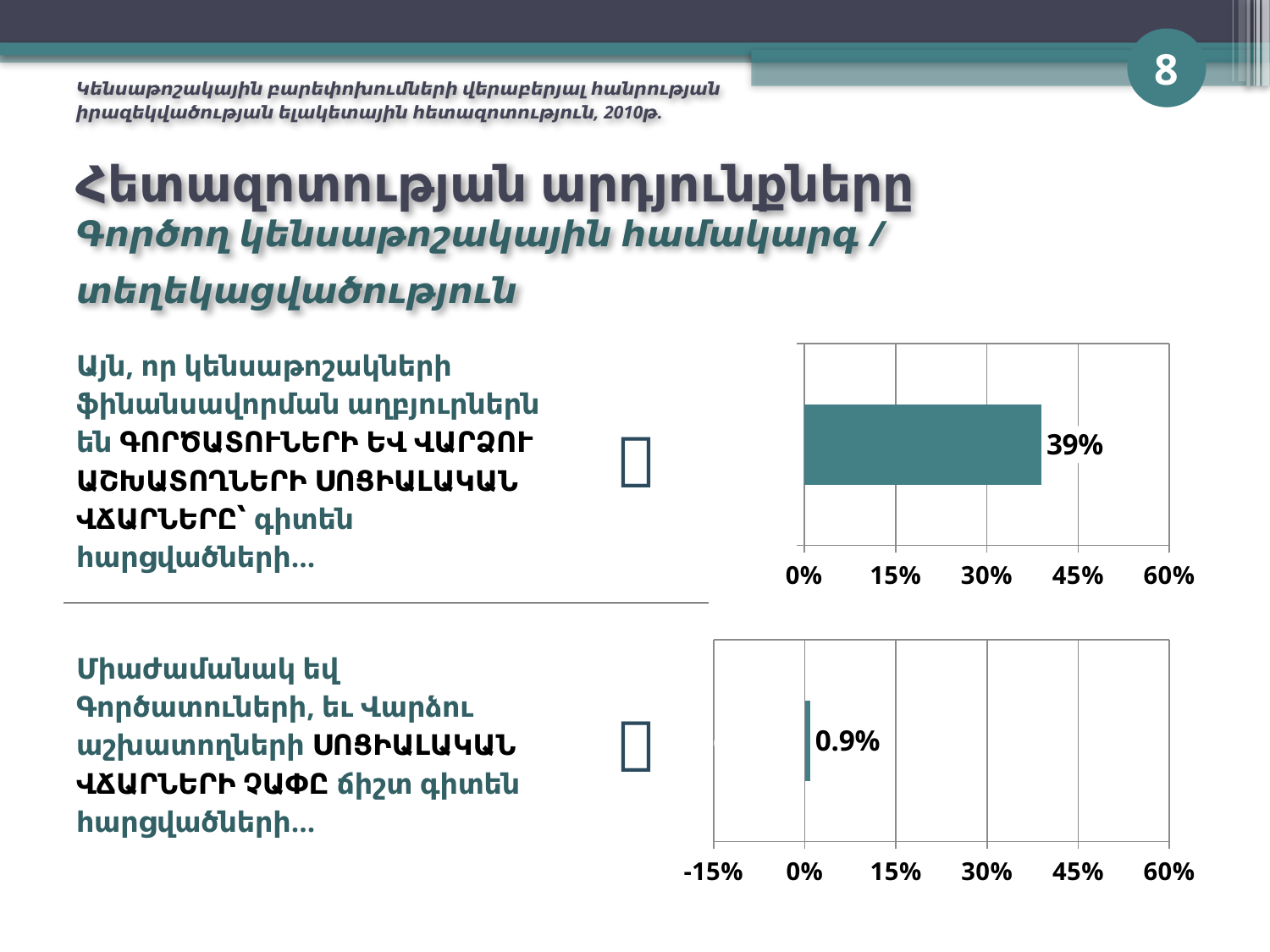
In the bottom chart, is the value of the bar greater or less than 15%? less In the bottom chart, what value is shown on the data label of the bar? 0.9% What kind of chart is the top chart on the slide? bar chart In the top chart, is the value of the bar greater or less than 30%? greater What is the difference between the value in the top chart (39%) and the value in the bottom chart (0.9%)? 38.1% What kind of chart is the bottom chart on the slide? bar chart What is the maximum value shown on the x axis of the top chart? 60% In the top chart, what value is shown on the data label of the bar? 39% How many bars are plotted in the top chart? 1 Which chart shows the larger value, the top chart or the bottom chart? top chart In the top chart, is the value of the bar greater or less than 45%? less What is the minimum value shown on the x axis of the bottom chart? -15%